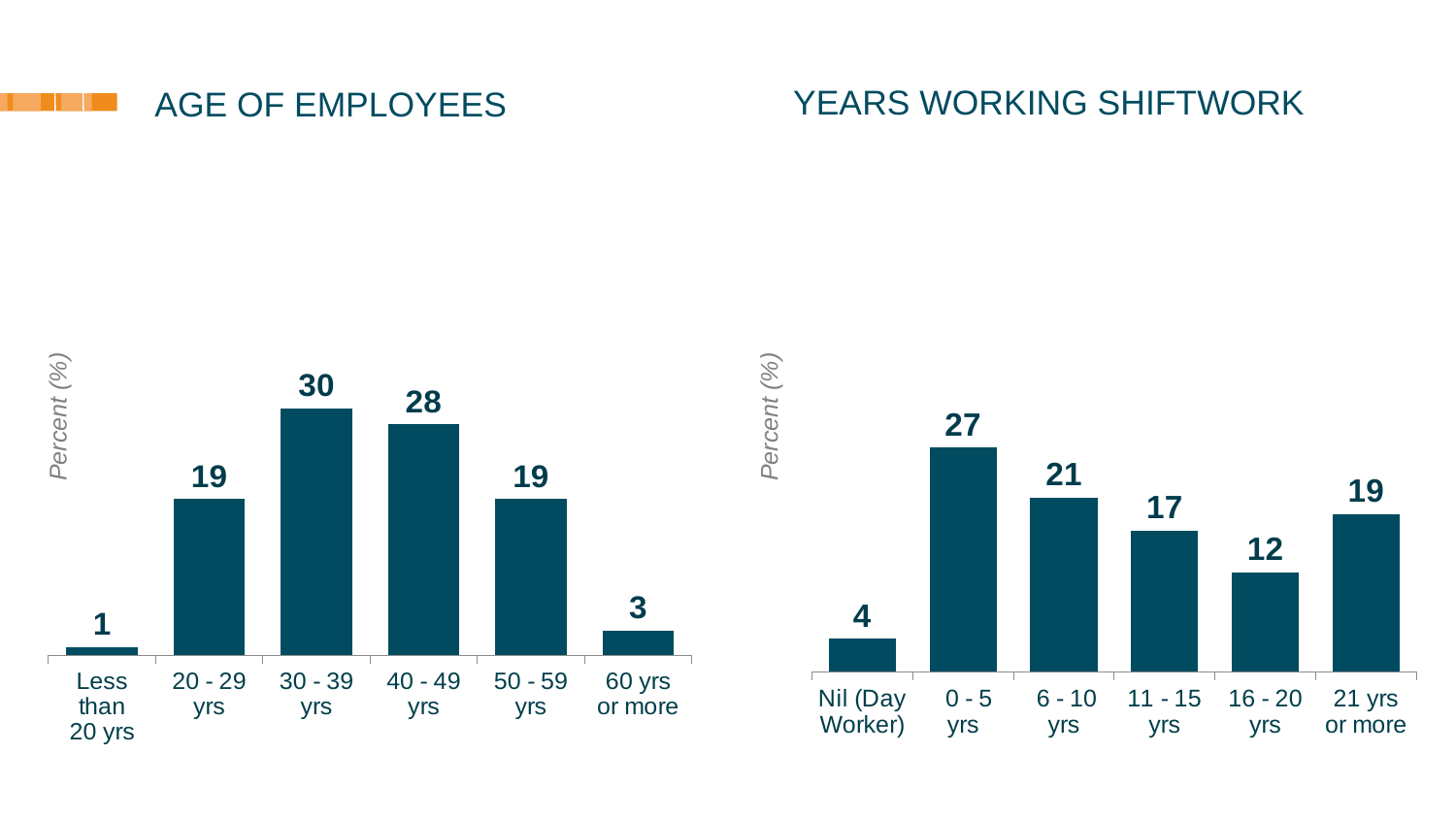
In the AGE OF EMPLOYEES chart, how many age categories are shown? 6 In the AGE OF EMPLOYEES chart, which age group has the lowest value? Less than 20 yrs In the YEARS WORKING SHIFTWORK chart, what is the value for Nil (Day Worker)? 4 What kind of chart is the YEARS WORKING SHIFTWORK chart? Bar chart In the AGE OF EMPLOYEES chart, what is the difference between the values for 30 - 39 yrs and 40 - 49 yrs? 2 What is the y-axis label on the AGE OF EMPLOYEES chart? Percent (%) In the YEARS WORKING SHIFTWORK chart, what is the difference between the values for 6 - 10 yrs and 16 - 20 yrs? 9 In the YEARS WORKING SHIFTWORK chart, what is the value for 21 yrs or more? 19 In the AGE OF EMPLOYEES chart, what is the value for 30 - 39 yrs? 30 In the AGE OF EMPLOYEES chart, which is larger, the value for 50 - 59 yrs or 60 yrs or more? 50 - 59 yrs In the YEARS WORKING SHIFTWORK chart, which is larger, the value for 11 - 15 yrs or 21 yrs or more? 21 yrs or more In the YEARS WORKING SHIFTWORK chart, which category has the highest value? 0 - 5 yrs